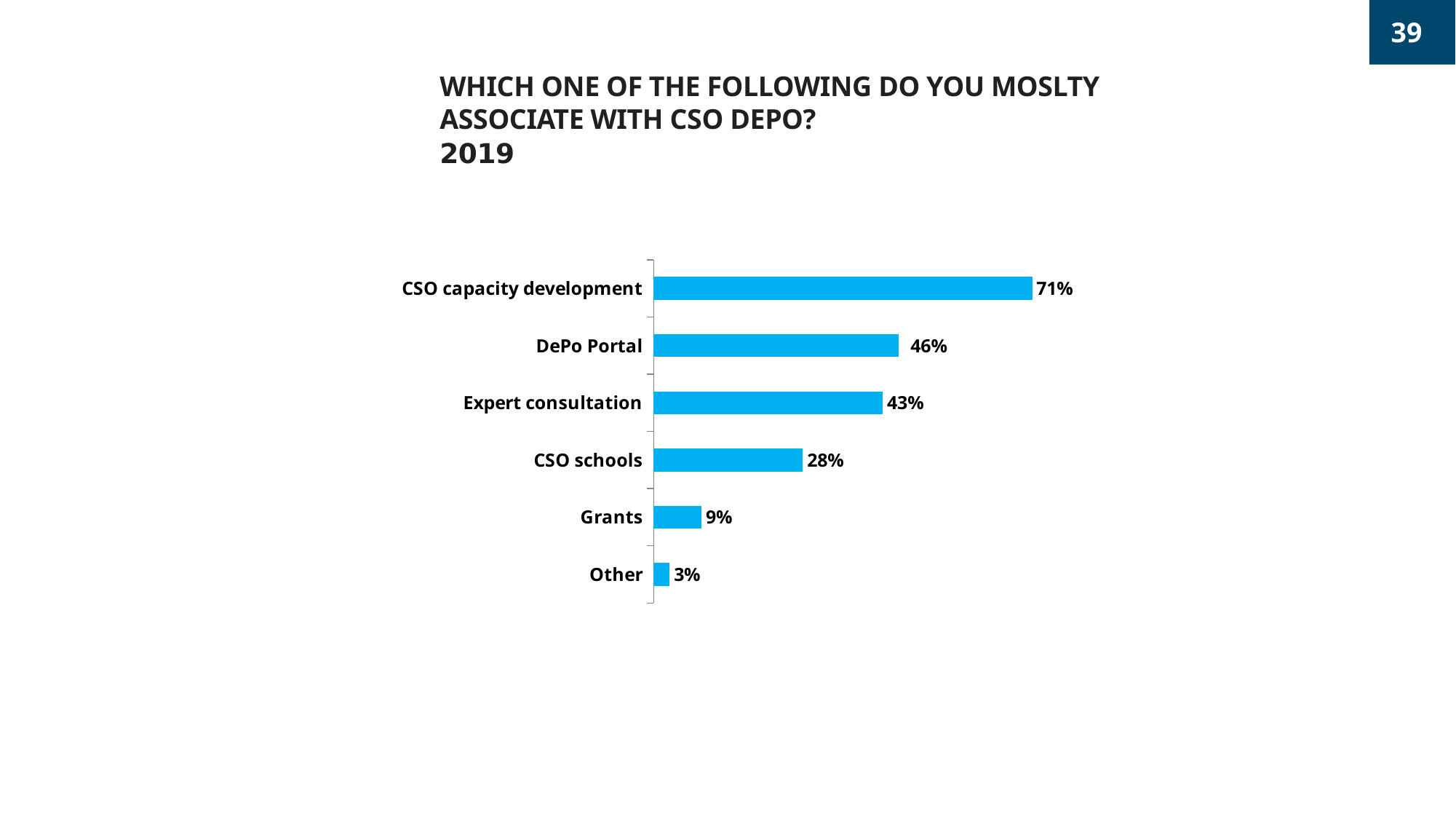
What is the difference between the values for CSO capacity development and DePo Portal? 25% How many categories are shown in the chart? 6 What is the value shown for Grants? 9% Which category has the lowest value? Other What year is given in the chart title? 2019 What percentage of respondents associate CSO capacity development with CSO DePo? 71% Which category has the highest value? CSO capacity development What is the difference between the values for Expert consultation and CSO schools? 15% What kind of chart is shown on the slide? Bar chart What is the value shown for DePo Portal? 46% Which has a larger value, DePo Portal or Expert consultation? DePo Portal What is the value shown for CSO schools? 28%